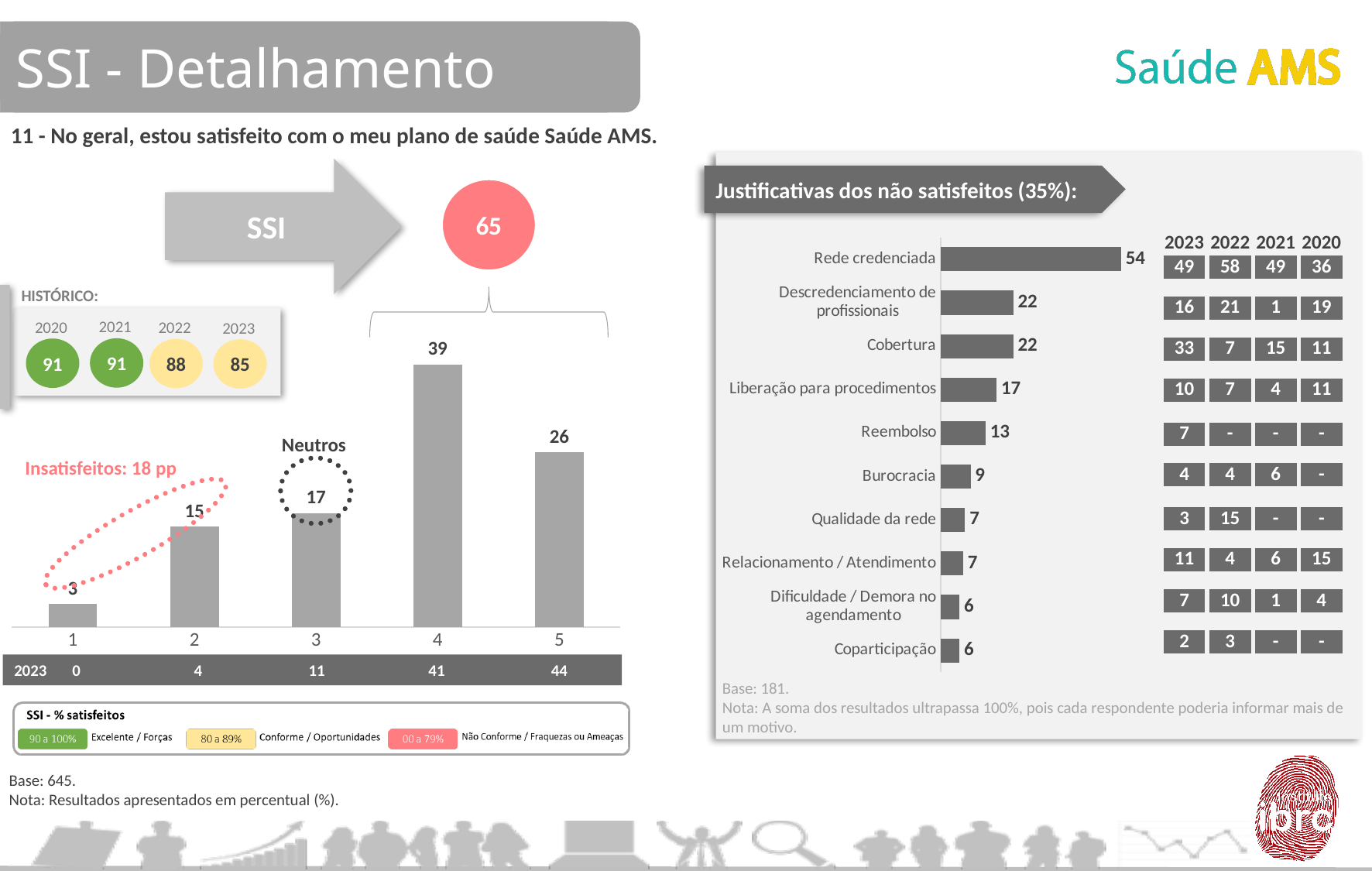
In the chart 'Justificativas dos não satisfeitos (35%)', how many categories are listed? 10 In the left bar chart (satisfaction scale 1 to 5), how many categories are shown on the x axis? 5 In the left bar chart (satisfaction scale 1 to 5), what is the value for category 4? 39 In the left bar chart (satisfaction scale 1 to 5), what is the difference between the values for categories 4 and 5? 13 In the chart 'Justificativas dos não satisfeitos (35%)', what is the difference between Rede credenciada and Cobertura? 32 In the left bar chart (satisfaction scale 1 to 5), which category has the highest value? 4 In the chart 'Justificativas dos não satisfeitos (35%)', which is larger, Liberação para procedimentos or Burocracia? Liberação para procedimentos In the chart 'Justificativas dos não satisfeitos (35%)', which category has the highest value? Rede credenciada In the chart 'Justificativas dos não satisfeitos (35%)', what is the value for Reembolso? 13 In the chart 'Justificativas dos não satisfeitos (35%)', what is the value for Rede credenciada? 54 In the left bar chart (satisfaction scale 1 to 5), what kind of chart is it? Bar chart In the left bar chart (satisfaction scale 1 to 5), which category has the lowest value? 1